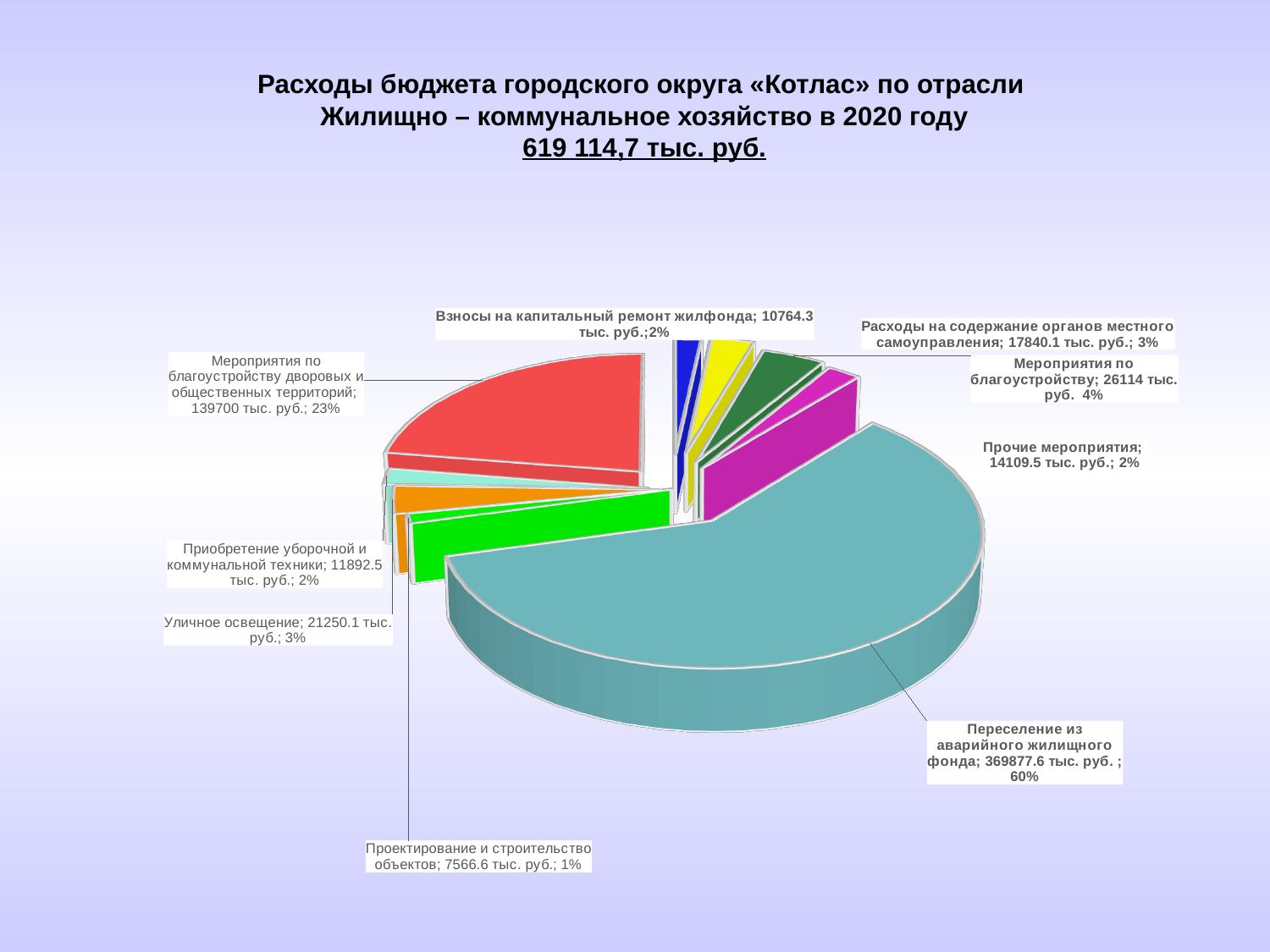
Which category has the smallest slice? Проектирование и строительство объектов What is the difference between «Мероприятия по благоустройству дворовых и общественных территорий» and «Уличное освещение»? 118449.9 тыс. руб. Which category has the largest slice? Переселение из аварийного жилищного фонда What share of the pie does «Мероприятия по благоустройству» represent? 4% What is the value for «Переселение из аварийного жилищного фонда»? 369877.6 тыс. руб. How many slices does the pie chart have? 9 What share of the pie does «Переселение из аварийного жилищного фонда» represent? 60% What total amount is stated in the chart title? 619 114,7 тыс. руб. What is the value for «Уличное освещение»? 21250.1 тыс. руб. Which is larger: «Расходы на содержание органов местного самоуправления» or «Мероприятия по благоустройству»? Мероприятия по благоустройству What is the value for «Мероприятия по благоустройству дворовых и общественных территорий»? 139700 тыс. руб. What kind of chart is shown on the slide? Pie chart